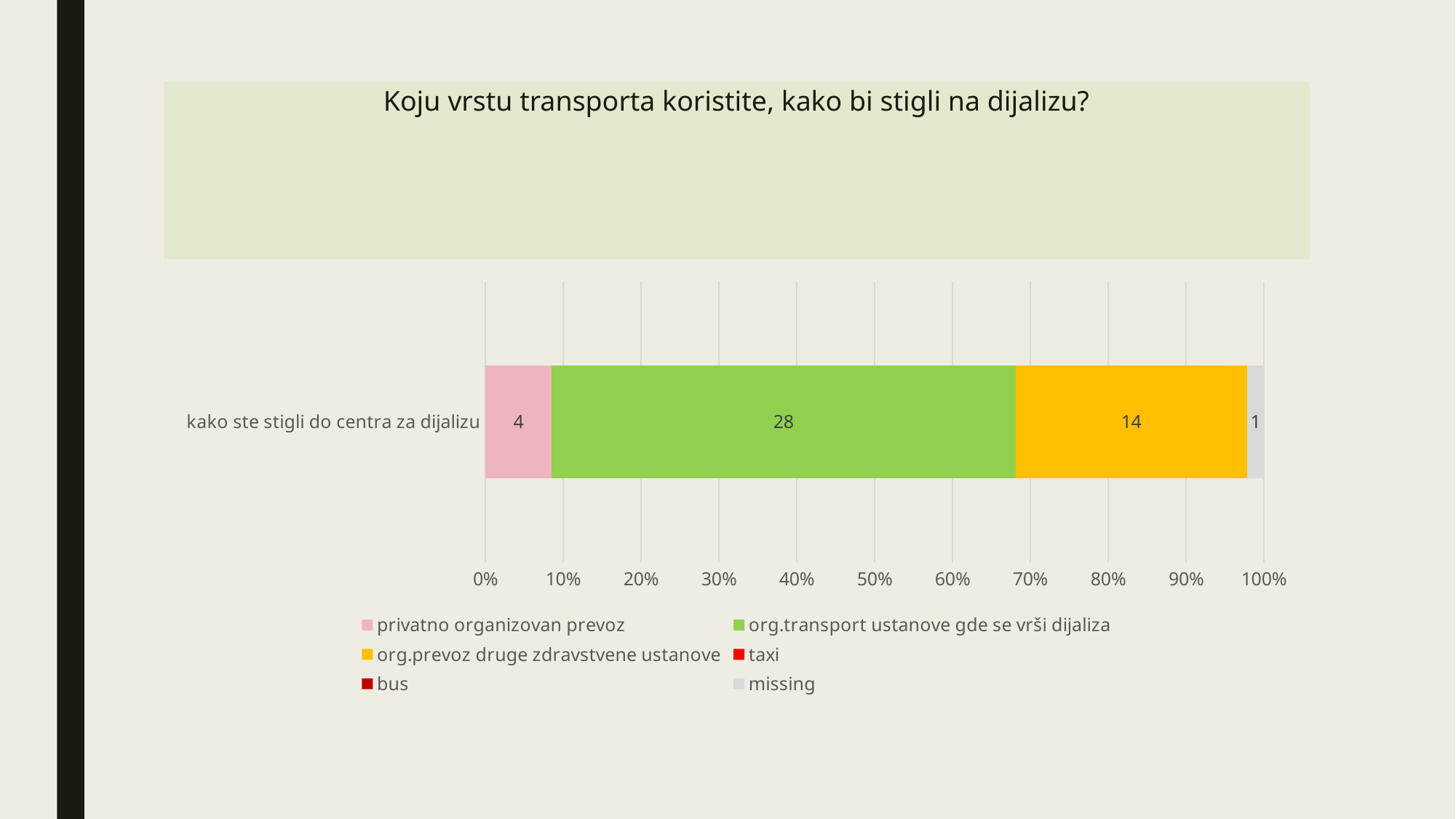
What value is shown for 'privatno organizovan prevoz'? 4 What value is shown for the 'missing' segment? 1 Which series has the largest labelled value in the bar? org.transport ustanove gde se vrši dijaliza Which series has the smallest labelled value in the bar? missing What value is shown for 'org.prevoz druge zdravstvene ustanove'? 14 Which is larger: the value for 'privatno organizovan prevoz' or for 'org.prevoz druge zdravstvene ustanove'? org.prevoz druge zdravstvene ustanove What colour is the segment for 'org.prevoz druge zdravstvene ustanove'? Yellow What is the difference between the values for 'org.transport ustanove gde se vrši dijaliza' and 'org.prevoz druge zdravstvene ustanove'? 14 What value is shown for 'org.transport ustanove gde se vrši dijaliza'? 28 What kind of chart is shown on the slide? Stacked bar chart What is the title of the chart? Koju vrstu transporta koristite, kako bi stigli na dijalizu? How many series does the legend list? 6